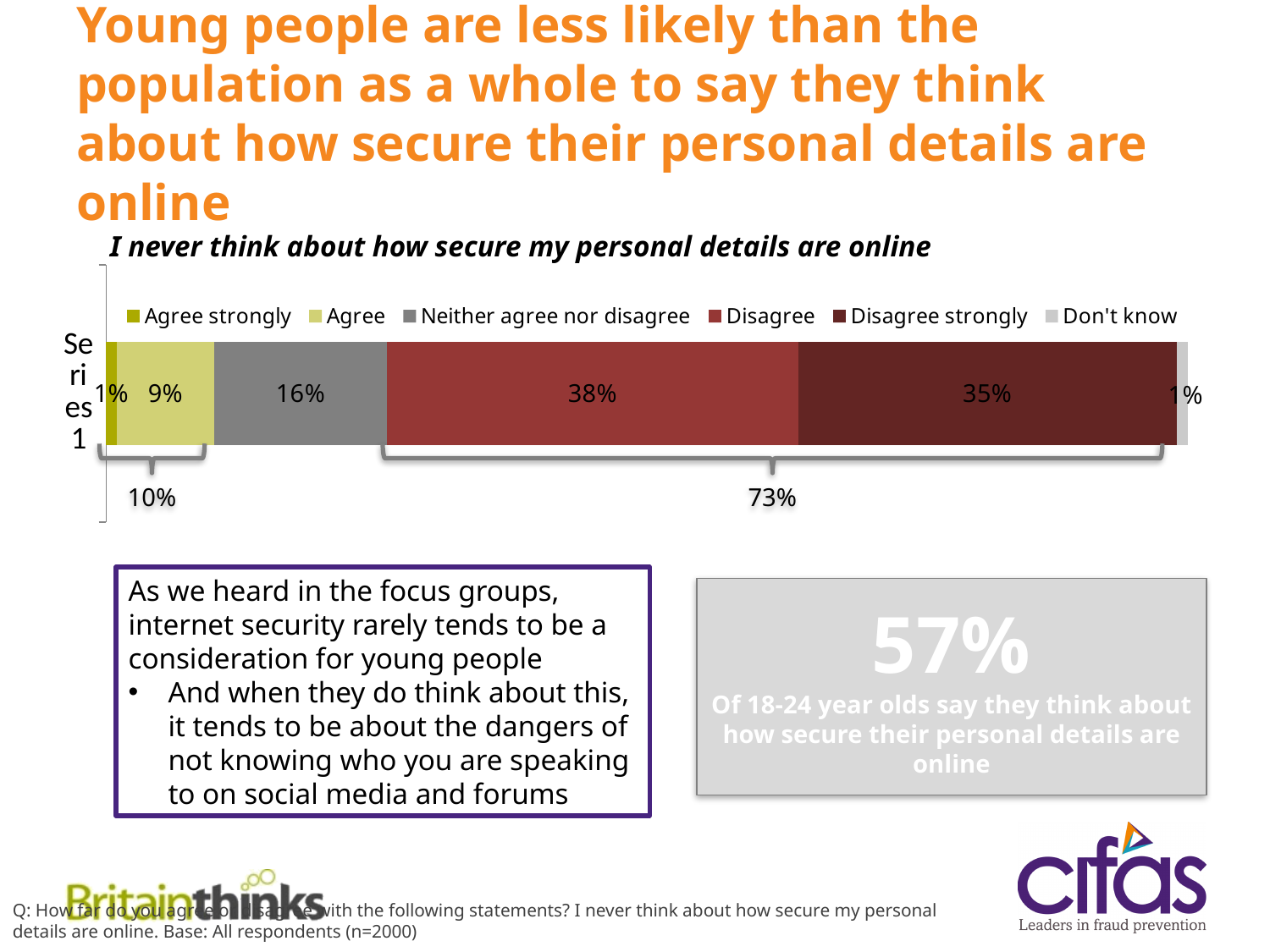
What percentage of respondents said 'Neither agree nor disagree'? 16% How many response categories does the legend list? 6 What combined percentage is shown by the bracket under the 'Disagree' and 'Disagree strongly' segments? 73% Which is larger, the 'Neither agree nor disagree' share or the 'Agree' share? Neither agree nor disagree What is the difference between the 'Disagree' and 'Disagree strongly' percentages? 3% What is the title of the chart? I never think about how secure my personal details are online What kind of chart is shown on the slide? Stacked bar chart What percentage of respondents said they 'Disagree strongly'? 35% Which response category has the largest share of the bar? Disagree What combined percentage is shown by the bracket under the 'Agree strongly' and 'Agree' segments? 10% What percentage of respondents said they 'Agree'? 9% What percentage of respondents said they 'Disagree' with the statement 'I never think about how secure my personal details are online'? 38%